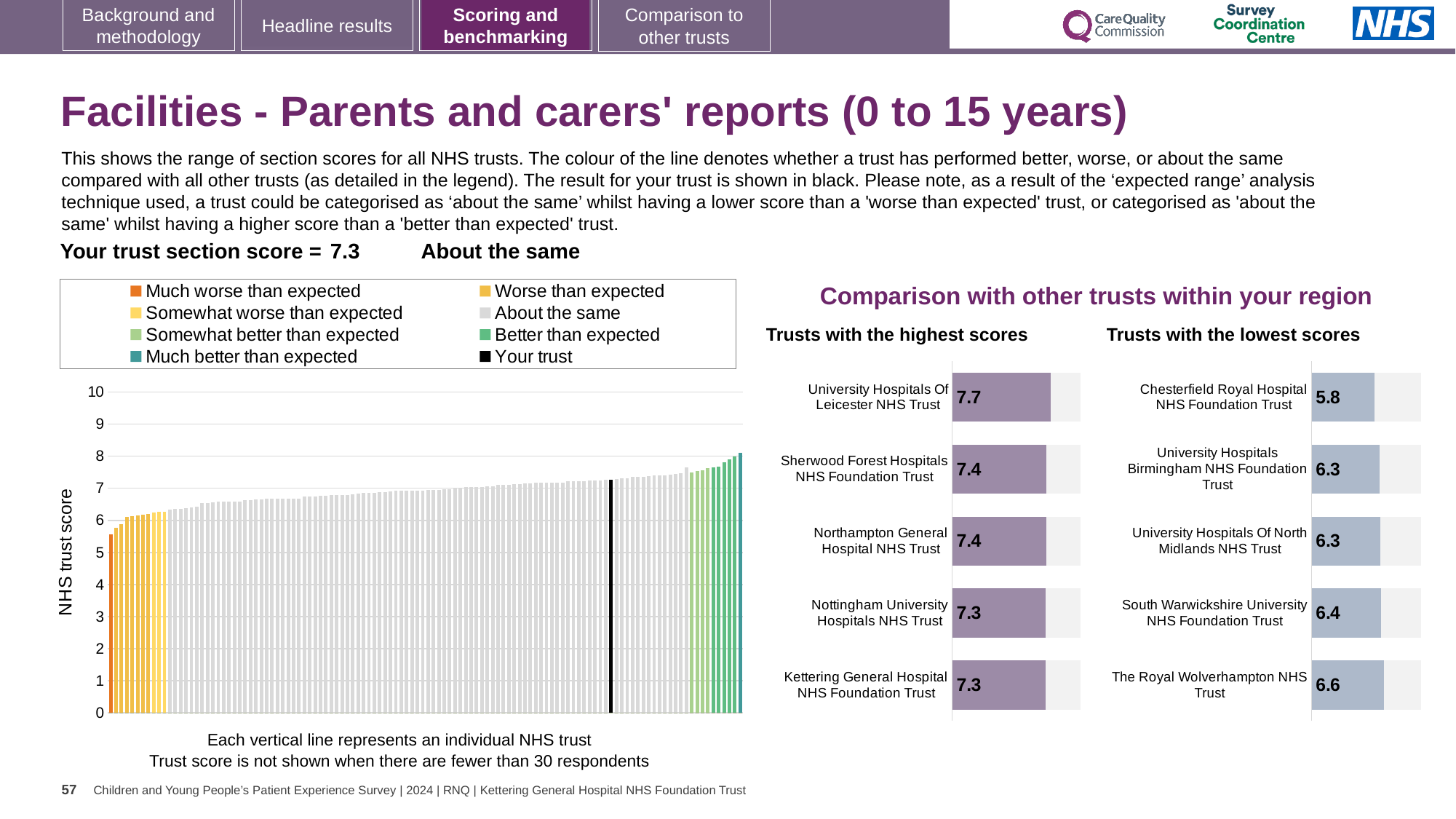
In the 'Trusts with the lowest scores' chart, which has the larger score: South Warwickshire University NHS Foundation Trust or Chesterfield Royal Hospital NHS Foundation Trust? South Warwickshire University NHS Foundation Trust In the 'Trusts with the highest scores' chart, what is the difference between the scores of University Hospitals Of Leicester NHS Trust and Kettering General Hospital NHS Foundation Trust? 0.4 In the 'Trusts with the lowest scores' chart, what is the difference between the scores of The Royal Wolverhampton NHS Trust and Chesterfield Royal Hospital NHS Foundation Trust? 0.8 How many trusts are listed in the 'Trusts with the highest scores' chart? 5 In the large 'NHS trust score' chart on the left, is the value for the black 'Your trust' bar greater or less than 7? greater How many entries does the legend above the large 'NHS trust score' chart list? 8 In the 'Trusts with the highest scores' chart, what is the score for University Hospitals Of Leicester NHS Trust? 7.7 In the large 'NHS trust score' chart on the left, do the bar values rise or fall from left to right? rise In the 'Trusts with the highest scores' chart, which trust has the highest score? University Hospitals Of Leicester NHS Trust What kind of chart is the large 'NHS trust score' chart on the left? bar chart In the 'Trusts with the lowest scores' chart, which trust has the lowest score? Chesterfield Royal Hospital NHS Foundation Trust In the 'Trusts with the lowest scores' chart, what is the score for Chesterfield Royal Hospital NHS Foundation Trust? 5.8